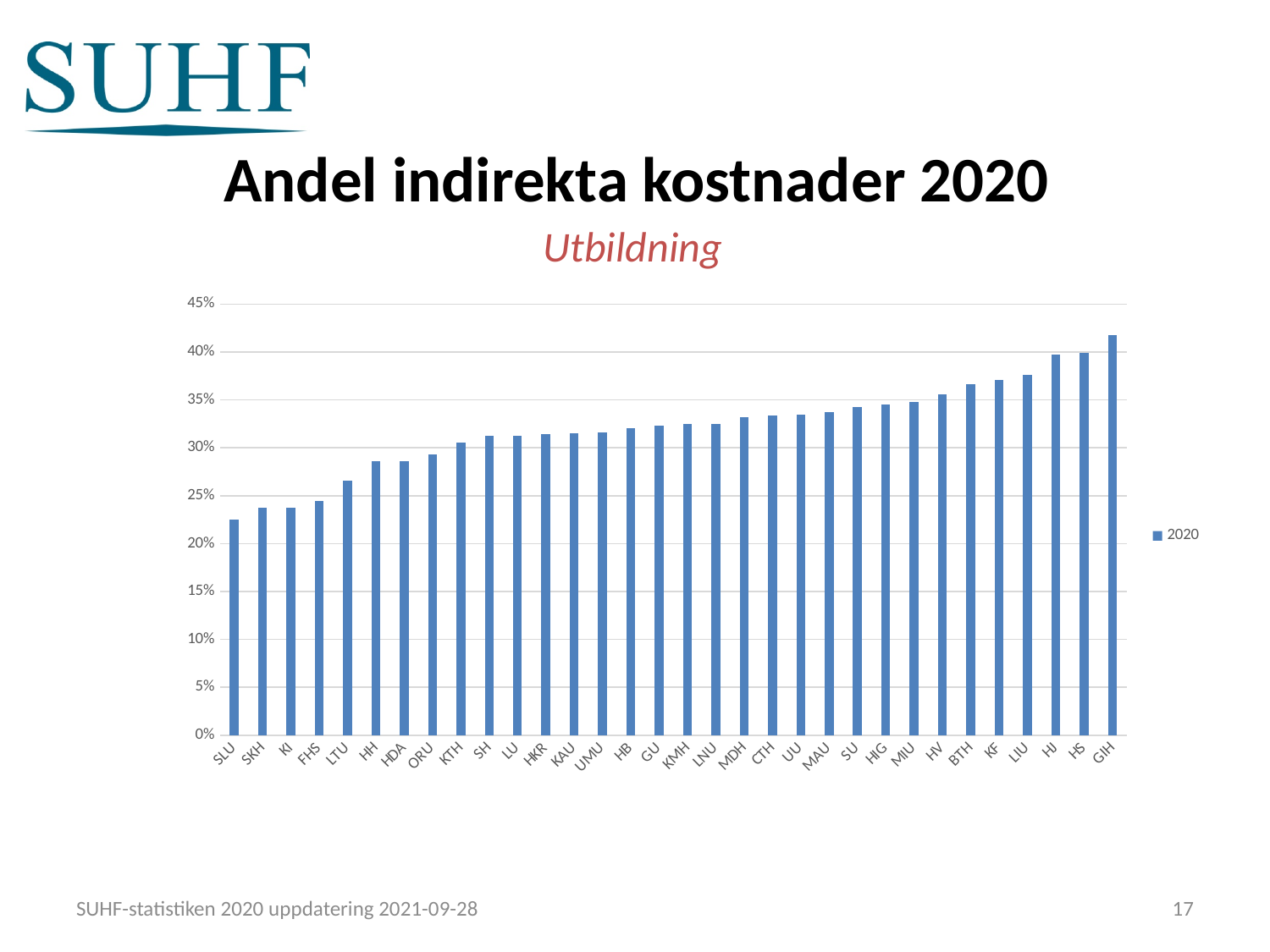
Which category has the highest value? GIH Is the value for GIH greater or less than 40%? greater Which has the larger value, KTH or HJ? HJ Which category has the lowest value? SLU Is the value for LTU greater or less than 25%? greater How many categories are plotted along the x axis? 32 Do the values rise or fall from left to right along the x axis? rise How many series does the legend list? 1 What is the legend entry for the series shown? 2020 Is the value for HV greater or less than 35%? greater What kind of chart is shown on the slide? bar chart